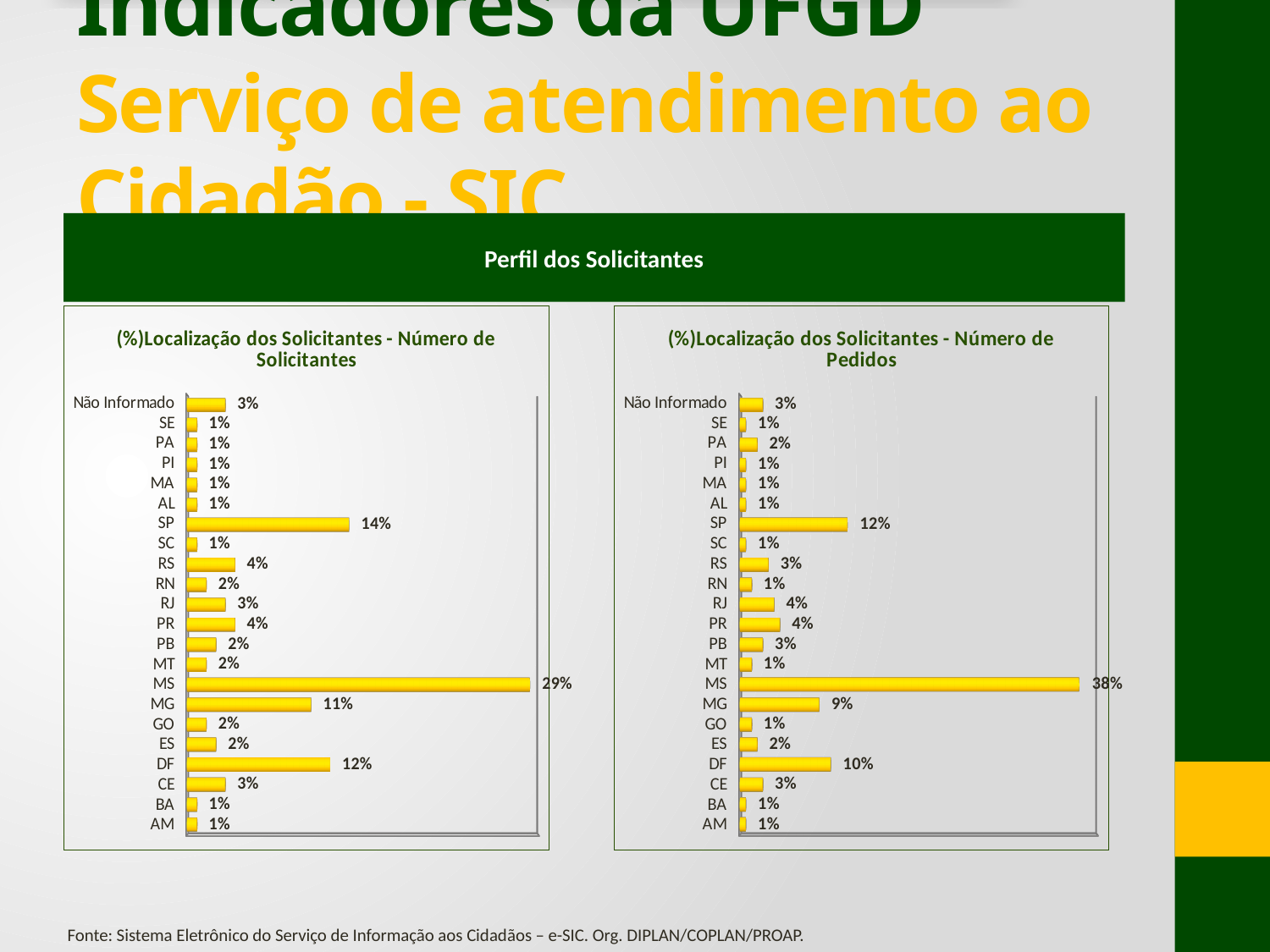
In the right chart (Número de Pedidos), what is the value for DF? 10% What kind of chart is the right chart (Número de Pedidos)? Bar chart In the left chart (Número de Solicitantes), what is the difference between the values for MS and SP? 15% In the left chart (Número de Solicitantes), which category has the highest value? MS In the left chart (Número de Solicitantes), which is larger, the value for DF or the value for MG? DF In the left chart (Número de Solicitantes), what is the value for SP? 14% In the chart titled "(%)Localização dos Solicitantes - Número de Pedidos", what is the value for MS? 38% In the right chart (Número de Pedidos), which is larger, the value for RJ or the value for RS? RJ In the right chart (Número de Pedidos), which category has the highest value? MS How many categories are shown in the left chart (Número de Solicitantes)? 22 In the chart titled "(%)Localização dos Solicitantes - Número de Solicitantes", what is the value for MS? 29% In the right chart (Número de Pedidos), what is the difference between the values for SP and MG? 3%